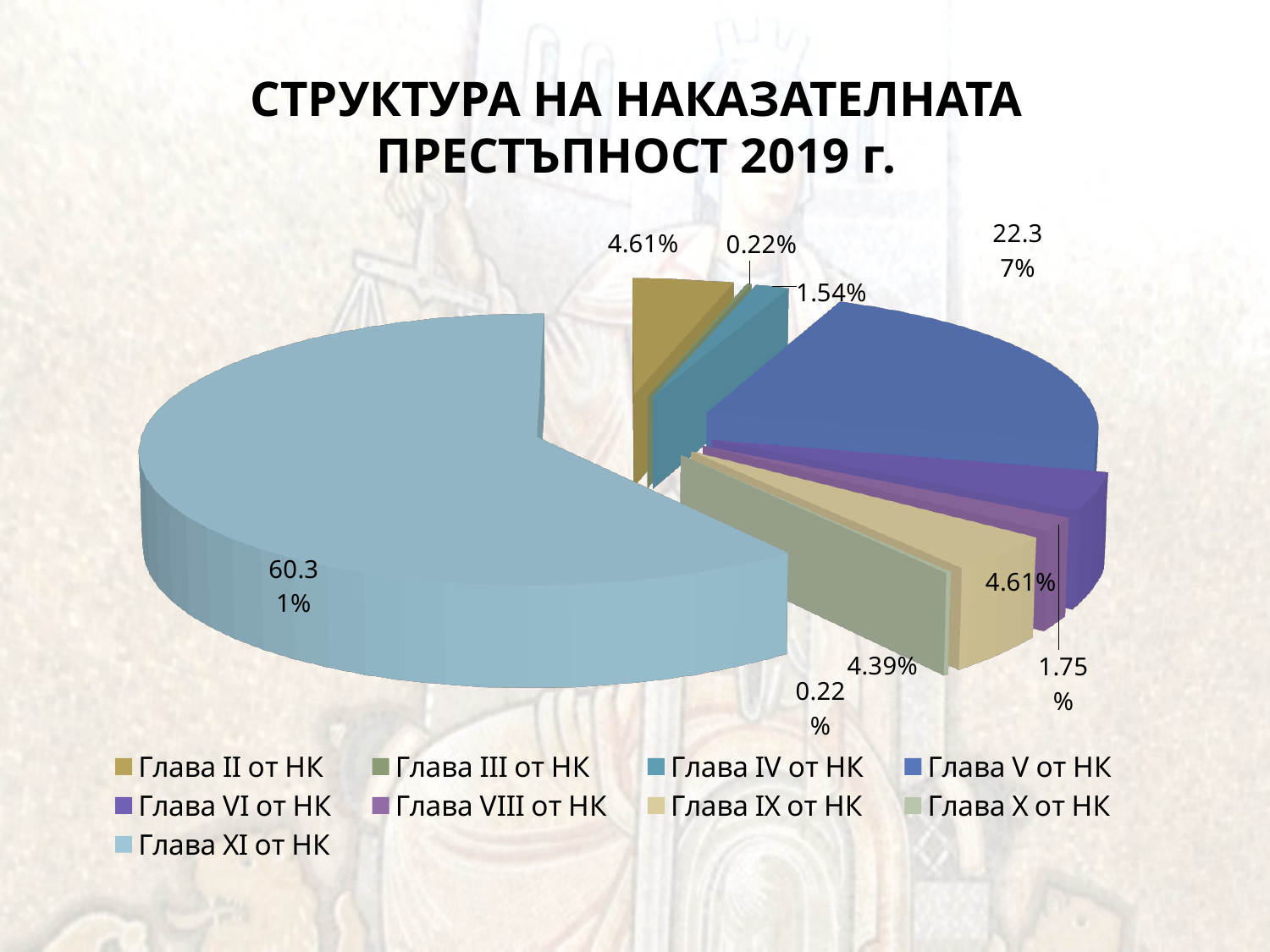
What is the value for Глава III от НК? 0.22% What is the value for Глава IX от НК? 4.39% How many categories does the legend list? 9 Which is larger, the share for Глава XI от НК or for Глава V от НК? Глава XI от НК What is the value for Глава V от НК? 22.37% What is the difference between the shares of Глава XI от НК and Глава V от НК? 37.94% What is the title of the chart? СТРУКТУРА НА НАКАЗАТЕЛНАТА ПРЕСТЪПНОСТ 2019 г. What kind of chart is shown on the slide? pie chart Which category has the largest share of the pie? Глава XI от НК What is the value for Глава II от НК? 4.61% What share of the pie does Глава XI от НК have? 60.31% What is the value for Глава IV от НК? 1.54%